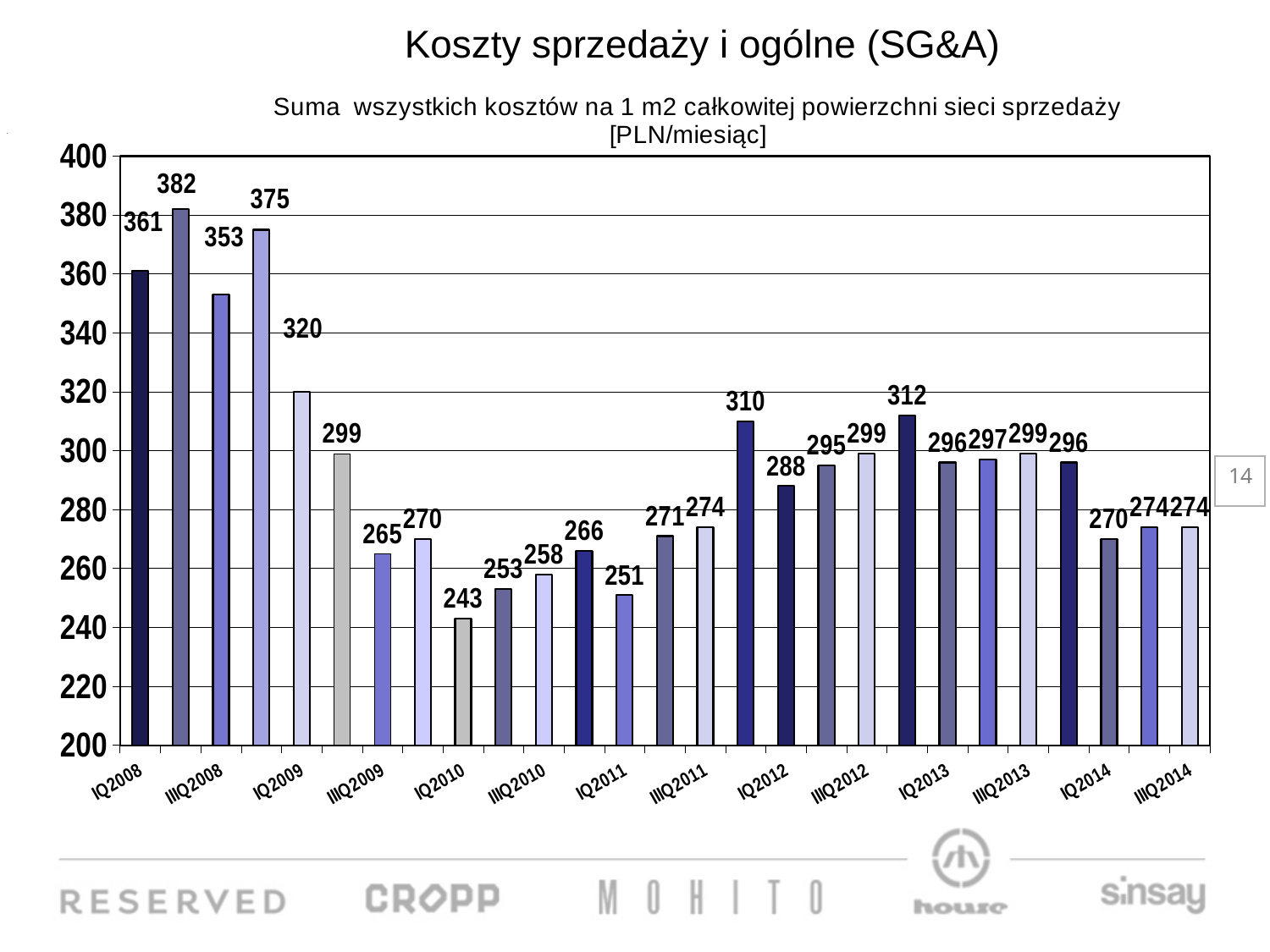
What kind of chart is shown on the slide? bar chart Is the value for IIIQ2011 greater or less than 280? less What is the difference between the values for IQ2008 and IQ2010? 118 What is the value for IQ2010? 243 What is the value for IIIQ2014? 274 What is the value for IQ2008? 361 What is the highest value shown on the chart? 382 Which is larger, the value for IQ2009 or the value for IQ2013? IQ2009 Do the values rise or fall from IQ2008 to IQ2010? fall How many bars are plotted on the chart? 27 Which labeled quarter has the lowest value? IQ2010 What is the value for IQ2012? 288